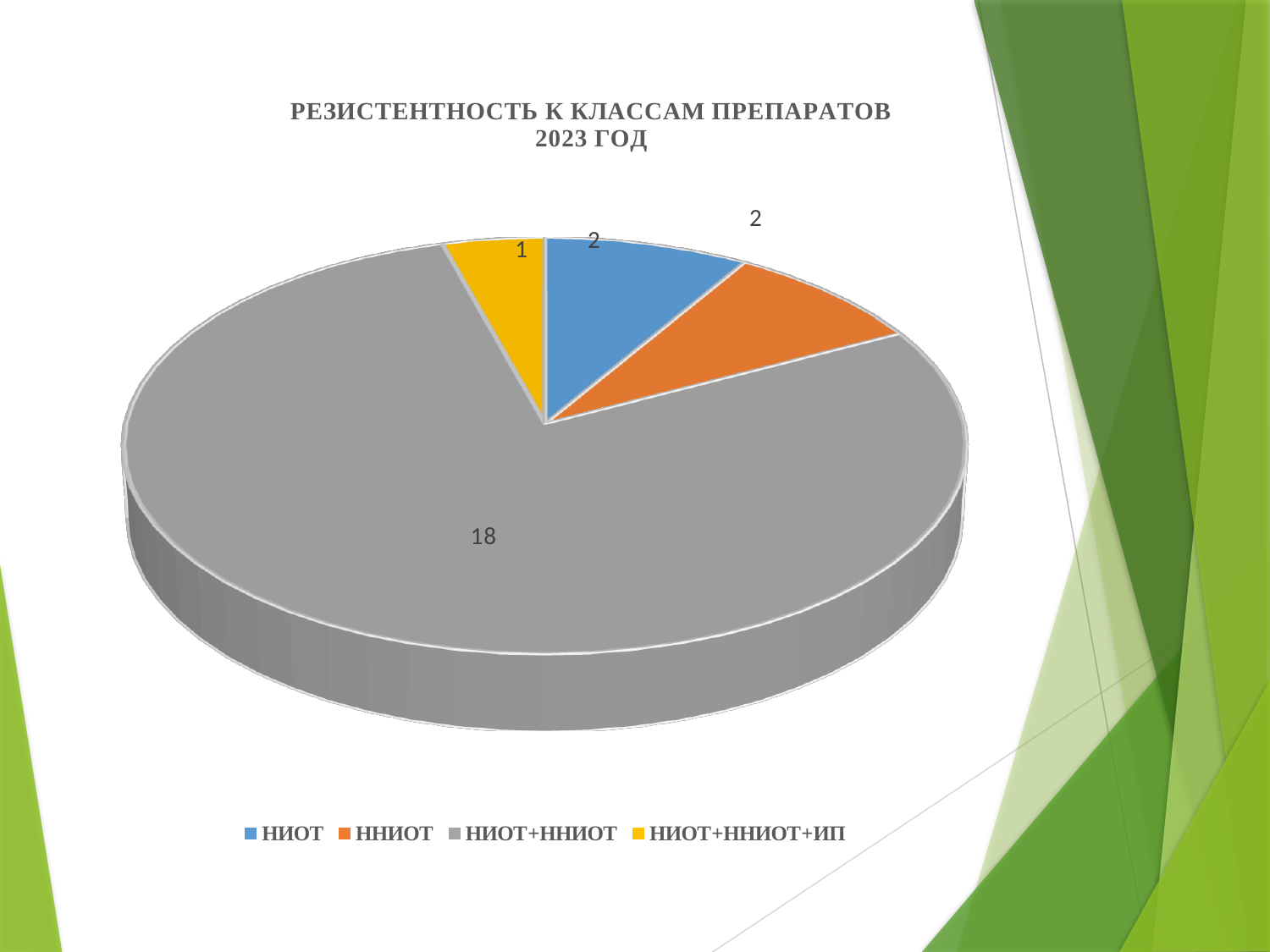
What is the value for НИОТ+ННИОТ? 18 What is the value for ННИОТ? 2 Which category has the largest slice? НИОТ+ННИОТ What is the difference between the values for НИОТ+ННИОТ and НИОТ? 16 What type of chart is shown on the slide? pie chart What is the value for НИОТ+ННИОТ+ИП? 1 What is the title of the chart? РЕЗИСТЕНТНОСТЬ К КЛАССАМ ПРЕПАРАТОВ 2023 ГОД How many categories does the legend list? 4 What colour is the slice for НИОТ+ННИОТ+ИП? yellow Which category has the smallest slice? НИОТ+ННИОТ+ИП What is the value for НИОТ? 2 Which is larger, the value for ННИОТ or the value for НИОТ+ННИОТ+ИП? ННИОТ